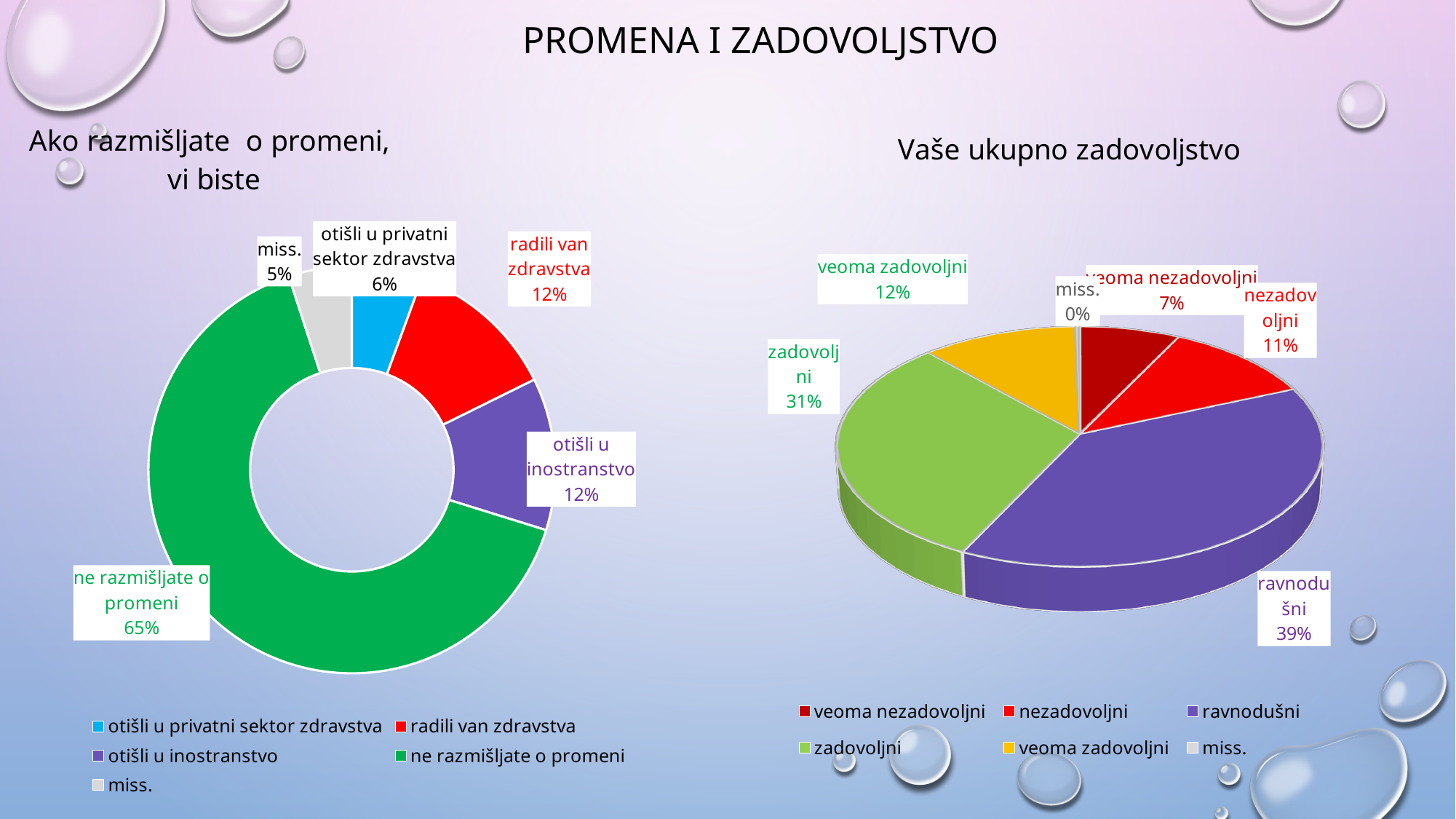
In the chart titled "Vaše ukupno zadovoljstvo", what percentage is shown for "ravnodušni"? 39% What type of chart is the chart titled "Vaše ukupno zadovoljstvo"? pie chart In the chart titled "Vaše ukupno zadovoljstvo", which is larger, "zadovoljni" or "nezadovoljni"? zadovoljni In the chart titled "Vaše ukupno zadovoljstvo", what is the combined percentage of "zadovoljni" and "veoma zadovoljni"? 43% In the chart titled "Ako razmišljate o promeni, vi biste", what is the difference in percentage points between "ne razmišljate o promeni" and "radili van zdravstva"? 53 How many categories does the legend of the chart titled "Ako razmišljate o promeni, vi biste" list? 5 In the chart titled "Ako razmišljate o promeni, vi biste", which category has the largest share? ne razmišljate o promeni In the chart titled "Ako razmišljate o promeni, vi biste", which category has the smallest share? miss. In the chart titled "Vaše ukupno zadovoljstvo", what percentage is shown for "veoma nezadovoljni"? 7% What type of chart is the chart titled "Ako razmišljate o promeni, vi biste"? doughnut chart In the chart titled "Ako razmišljate o promeni, vi biste", what percentage is shown for "otišli u privatni sektor zdravstva"? 6% In the chart titled "Ako razmišljate o promeni, vi biste", what percentage is shown for "ne razmišljate o promeni"? 65%